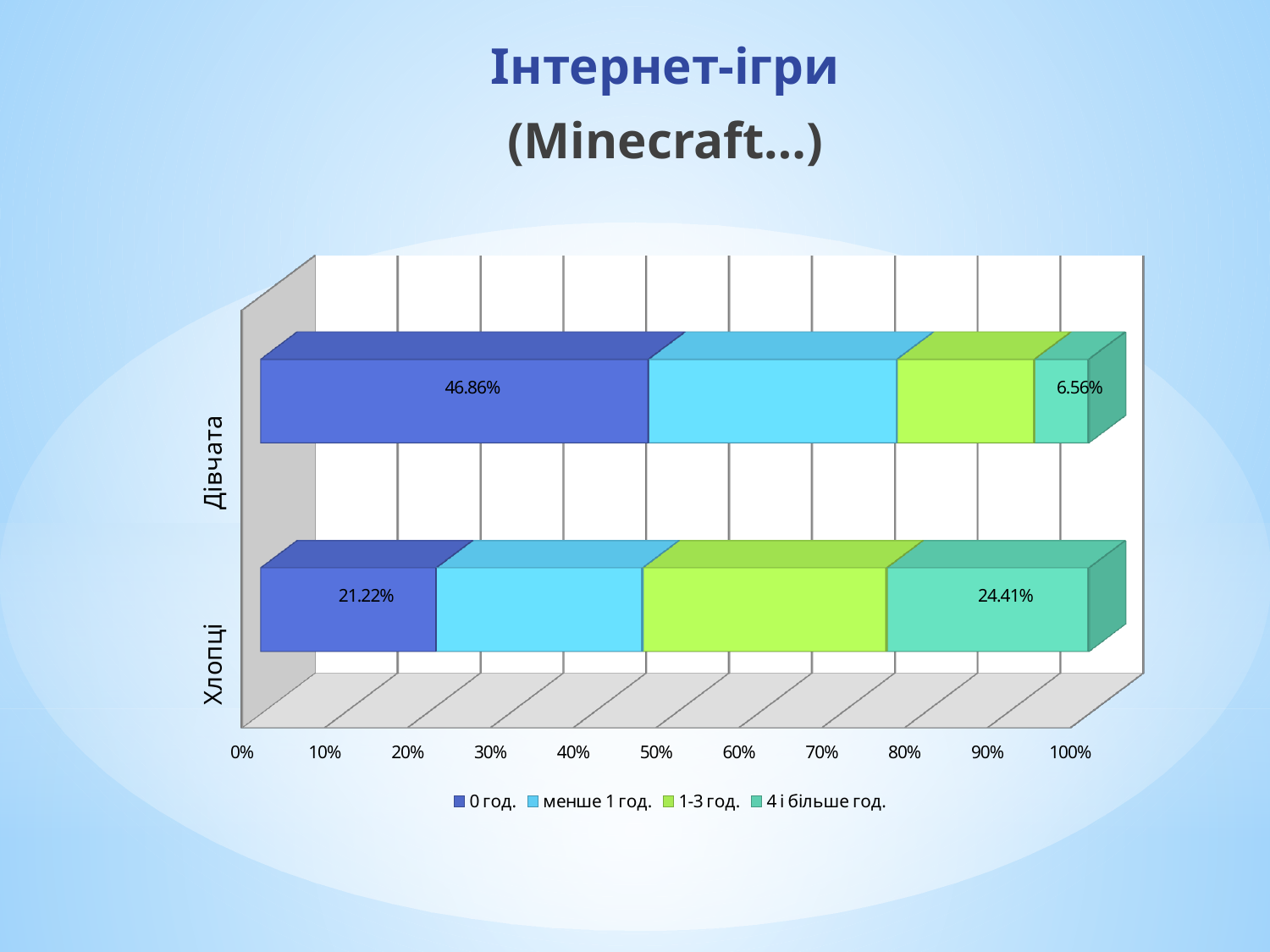
What is the value of the "0 год." segment for Дівчата? 46.86% Which category has the larger "4 і більше год." value, Дівчата or Хлопці? Хлопці What is the value of the "4 і більше год." segment for Дівчата? 6.56% What kind of chart is shown on the slide? stacked bar chart What is the title of the slide? Інтернет-ігри (Minecraft…) How many categories are shown on the vertical axis? 2 What is the difference between the "4 і більше год." values for Хлопці and Дівчата? 17.85% How many series does the legend list? 4 What is the value of the "0 год." segment for Хлопці? 21.22% What is the value of the "4 і більше год." segment for Хлопці? 24.41% What is the difference between the "0 год." values for Дівчата and Хлопці? 25.64% Which category has the larger "0 год." value, Дівчата or Хлопці? Дівчата